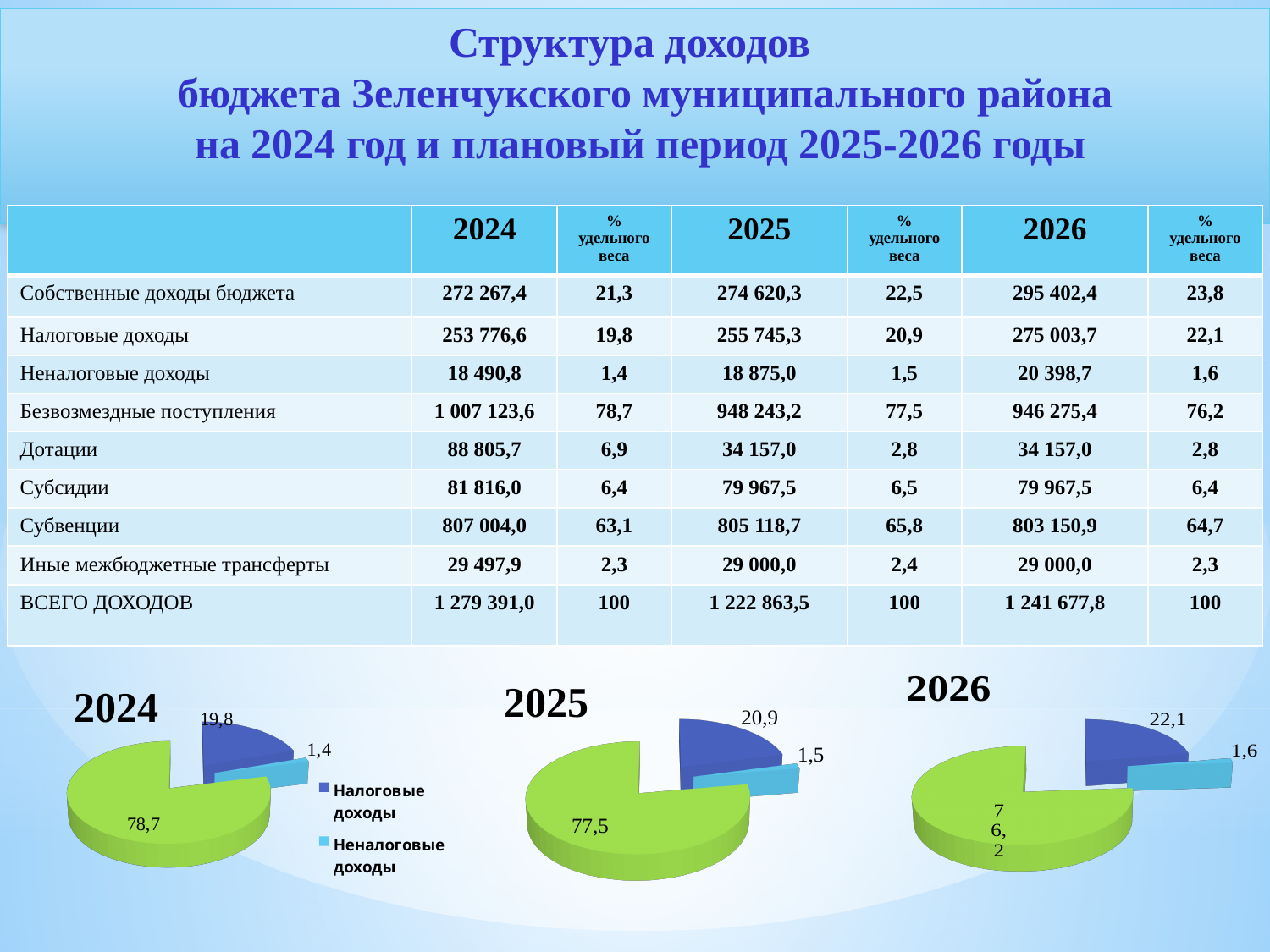
How many entries does the legend next to the 2024 pie chart list? 2 In the 2025 pie chart, which slice is the smallest? Неналоговые доходы In the 2026 pie chart, what value is shown for Неналоговые доходы? 1,6 In the 2025 pie chart, what value is shown for Налоговые доходы? 20,9 In the 2026 pie chart, what value is shown for Налоговые доходы? 22,1 How many slices does the 2026 pie chart have? 3 In the 2024 pie chart, what value is shown for Неналоговые доходы? 1,4 In the 2024 pie chart, what is the difference between the Налоговые доходы value and the Неналоговые доходы value? 18,4 What kind of chart is the 2024 chart at the bottom of the slide? Pie chart In the 2024 pie chart, what value is shown on the large green slice? 78,7 In the 2025 pie chart, what value is shown for Неналоговые доходы? 1,5 In the 2024 pie chart, what value is shown for Налоговые доходы? 19,8